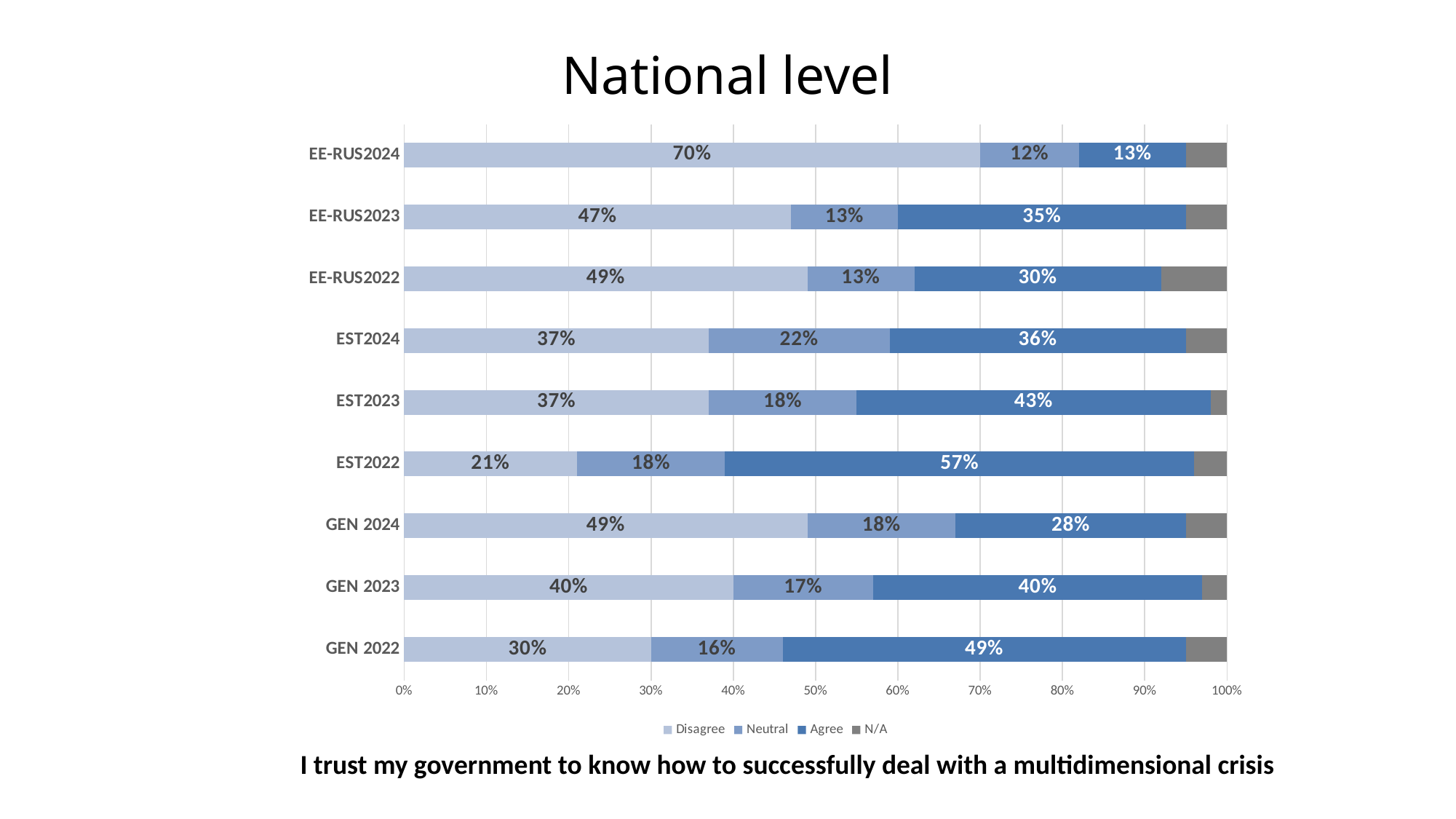
How many categories are shown on the y axis? 9 What percentage of EE-RUS2024 respondents disagree? 70% Which is larger, the Disagree value for GEN 2024 or the Disagree value for GEN 2022? GEN 2024 Which category has the highest Disagree value? EE-RUS2024 What is the title of the chart? National level What is the difference between the Disagree and Agree values for GEN 2022? 19% Which category has the lowest Agree value? EE-RUS2024 What is the Agree value for EST2022? 57% How many series does the legend list? 4 What kind of chart is shown on the slide? Stacked bar chart What is the difference between the Agree values for EST2022 and EST2024? 21% What is the Neutral value for GEN 2023? 17%